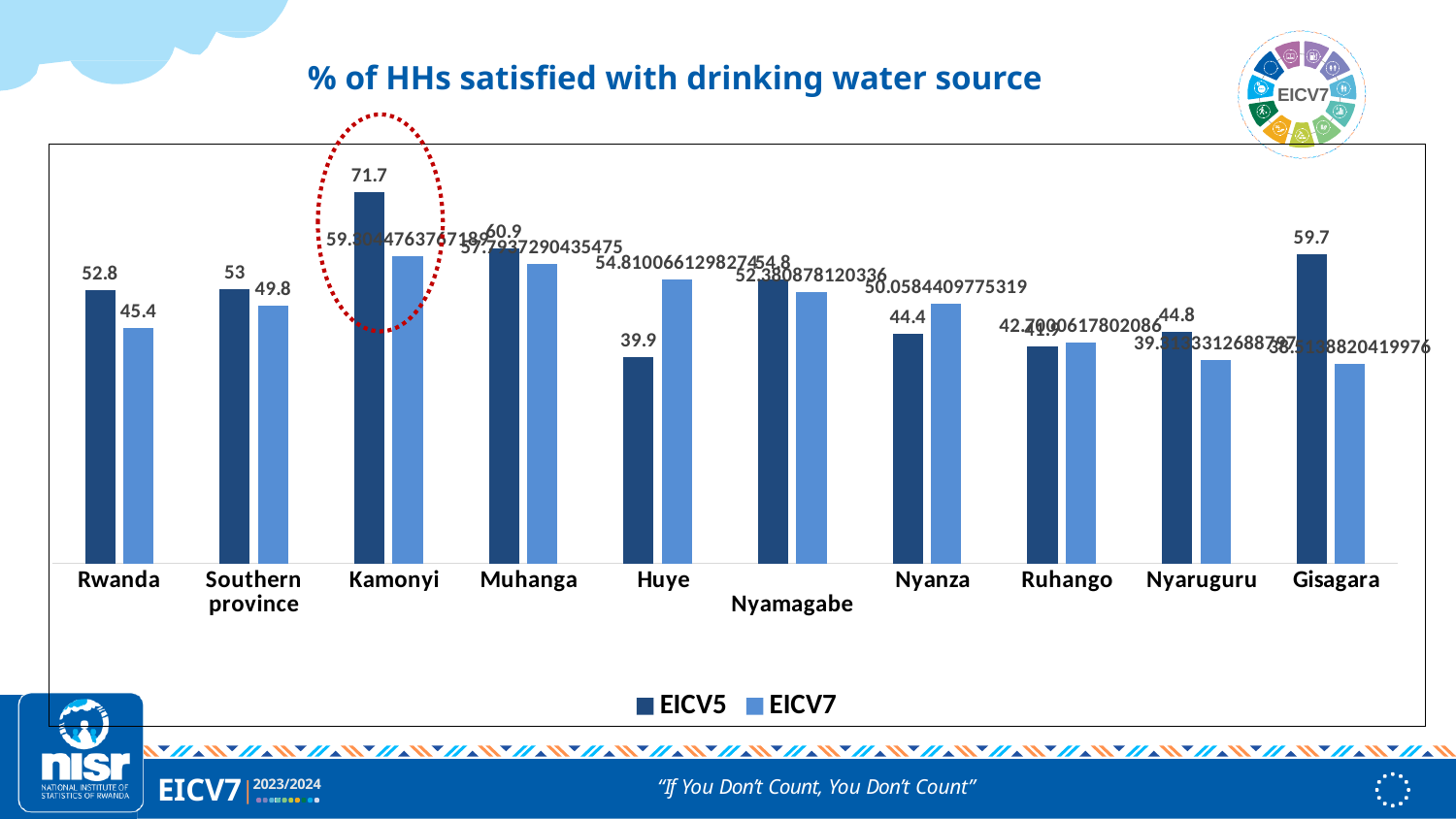
What is the EICV7 value for Rwanda? 45.4 What is the difference between the EICV5 and EICV7 values for Rwanda? 7.4 What is the EICV5 value for Kamonyi? 71.7 Which district has the highest EICV5 value? Kamonyi What is the EICV5 value for Rwanda? 52.8 What is the EICV7 value for Southern province? 49.8 How many categories are shown on the x axis? 10 Which category has the lowest EICV5 value? Huye What is the EICV5 value for Gisagara? 59.7 How many series does the legend list? 2 What kind of chart is shown on the slide? Bar chart For Huye, which is larger: the EICV5 value or the EICV7 value? EICV7